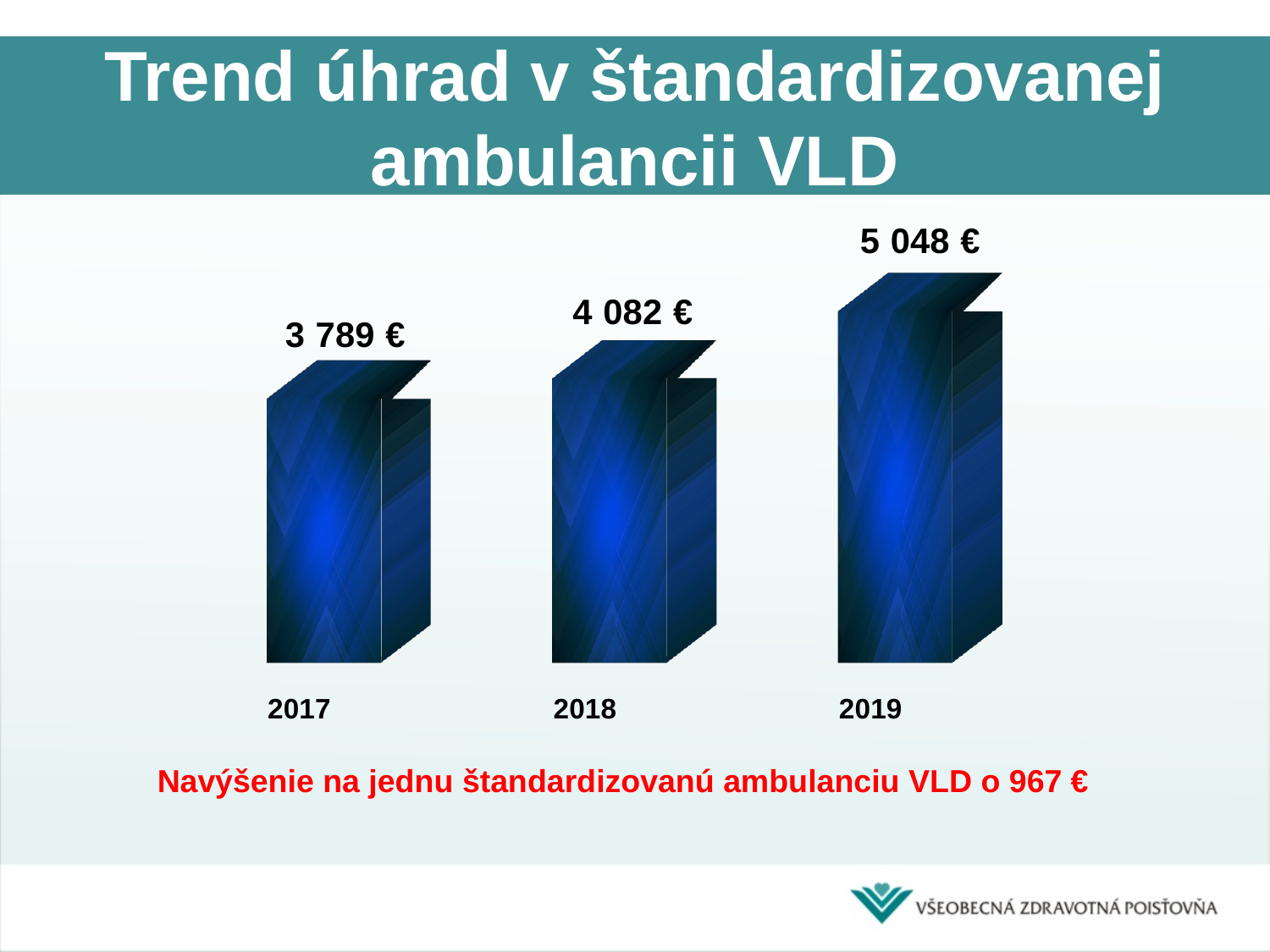
Which is larger, the value for 2018 or the value for 2019? 2019 What is the value shown for 2018? 4 082 € What is the difference between the values for 2018 and 2017? 293 € What is the value shown for 2017? 3 789 € What is the title of the slide containing the chart? Trend úhrad v štandardizovanej ambulancii VLD What kind of chart is shown on the slide? Bar chart Which year has the highest value? 2019 Which year has the lowest value? 2017 Do the values rise or fall from 2017 to 2019? Rise What is the difference between the values for 2019 and 2017? 1 259 € What is the value shown for 2019? 5 048 € How many years are shown in the chart? 3